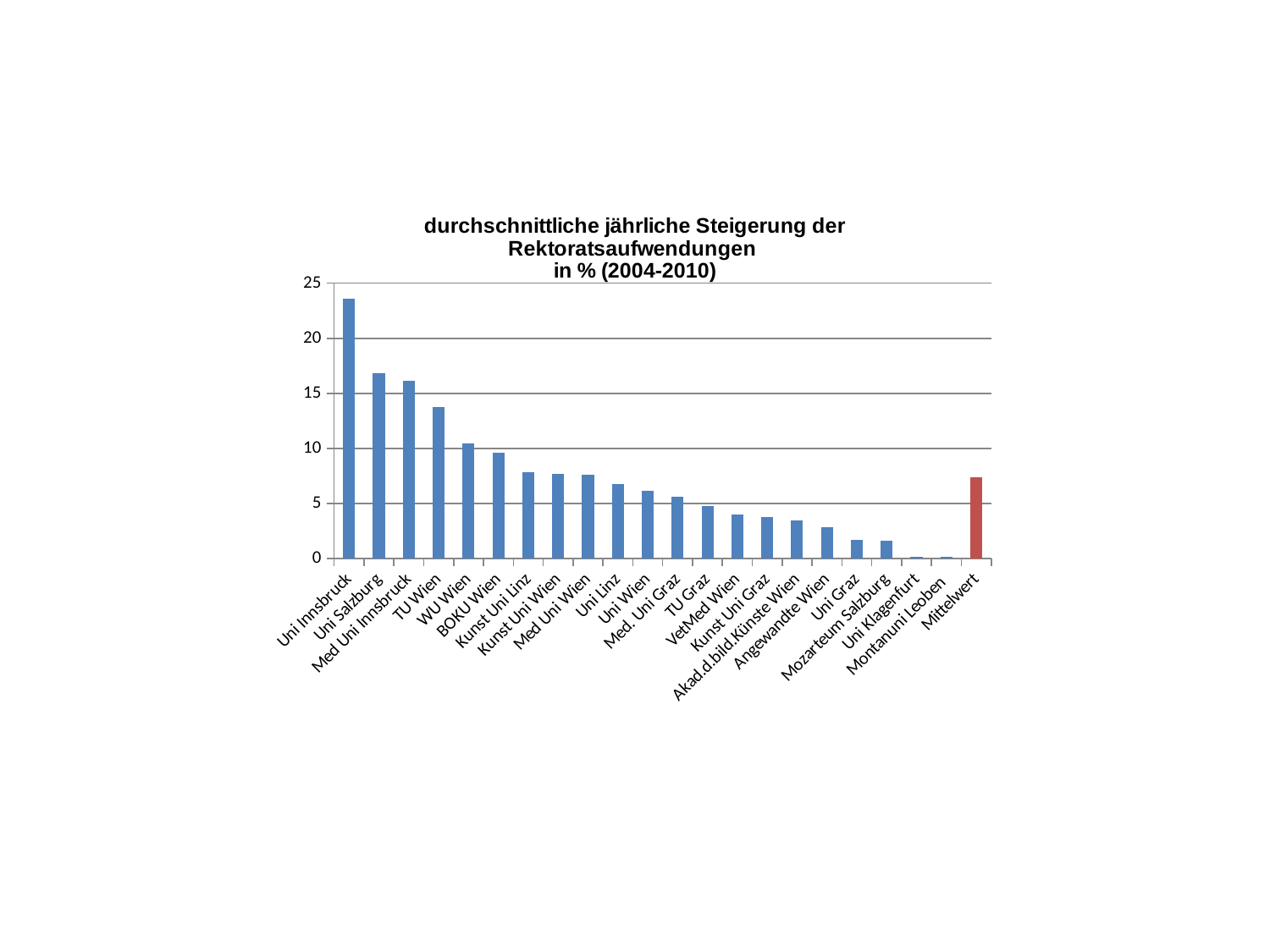
Which bar in the chart is coloured red instead of blue? Mittelwert Which university has the highest average annual increase in Rektoratsaufwendungen? Uni Innsbruck Which is larger, the value for Mittelwert or the value for Uni Graz? Mittelwert Is the value for Uni Salzburg greater or less than 15? greater Is the value for Mittelwert greater or less than 5? greater What kind of chart is shown on the slide? bar chart Is the value for Uni Graz greater or less than 5? less How many categories are shown on the x axis of the chart? 22 Which is larger, the value for Uni Salzburg or the value for TU Wien? Uni Salzburg Do the values for the universities rise or fall from left to right along the x axis (excluding the Mittelwert bar)? fall